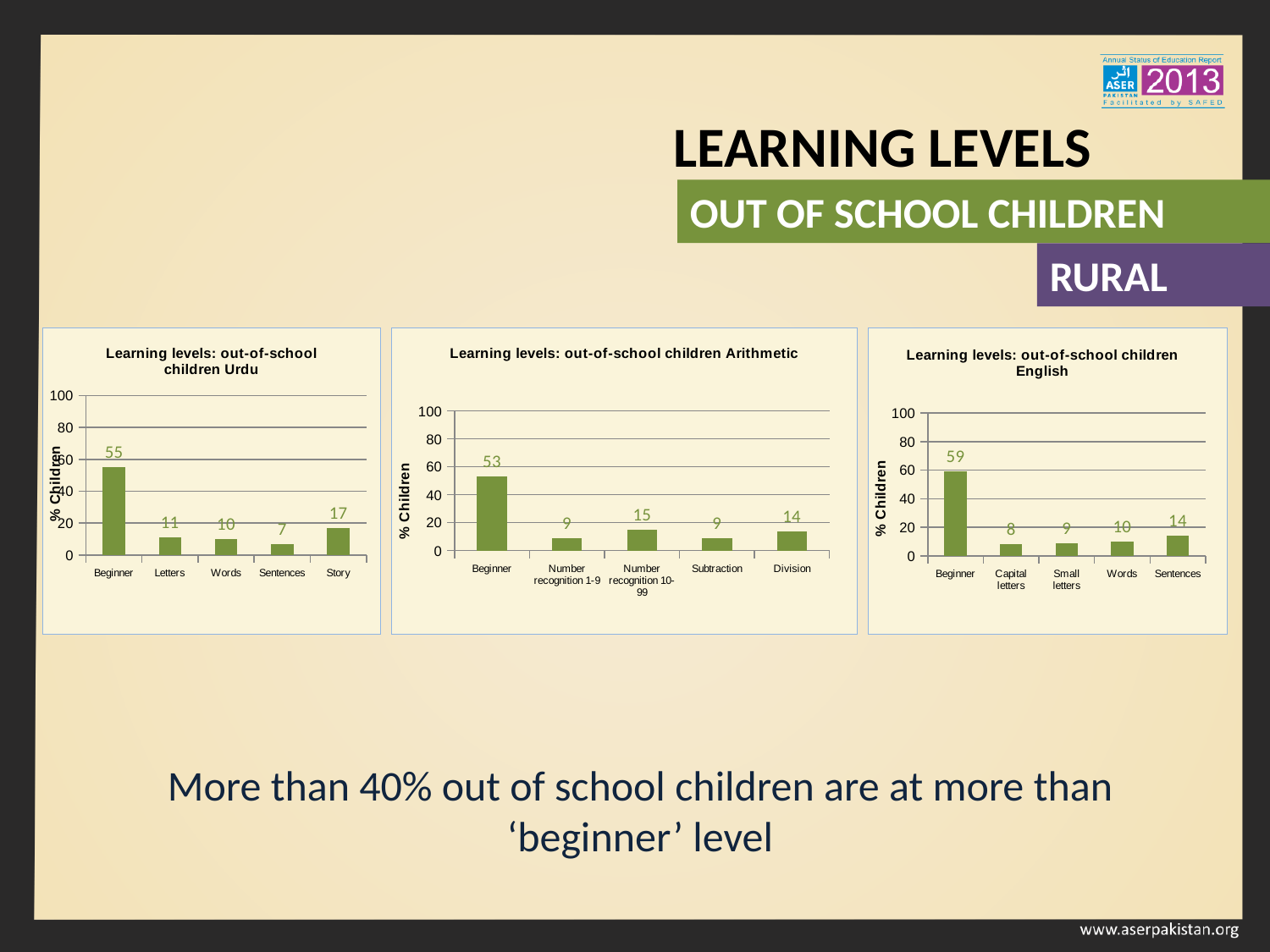
In the 'Learning levels: out-of-school children Urdu' chart, what is the difference between the values for Story and Letters? 6 In the 'Learning levels: out-of-school children Urdu' chart, which category has the lowest value? Sentences In the 'Learning levels: out-of-school children Arithmetic' chart, what is the value for Number recognition 10-99? 15 What kind of chart is the 'Learning levels: out-of-school children English' chart? bar chart In the 'Learning levels: out-of-school children English' chart, what is the value for Beginner? 59 What is the y-axis label on the 'Learning levels: out-of-school children Urdu' chart? % Children In the 'Learning levels: out-of-school children English' chart, what is the value for Capital letters? 8 In the 'Learning levels: out-of-school children Arithmetic' chart, how many categories are shown on the x axis? 5 In the 'Learning levels: out-of-school children Urdu' chart, what is the value for Beginner? 55 In the 'Learning levels: out-of-school children Arithmetic' chart, which category has the highest value? Beginner In the 'Learning levels: out-of-school children Arithmetic' chart, is the value for Division larger or smaller than the value for Subtraction? larger In the 'Learning levels: out-of-school children English' chart, what is the difference between the values for Beginner and Sentences? 45